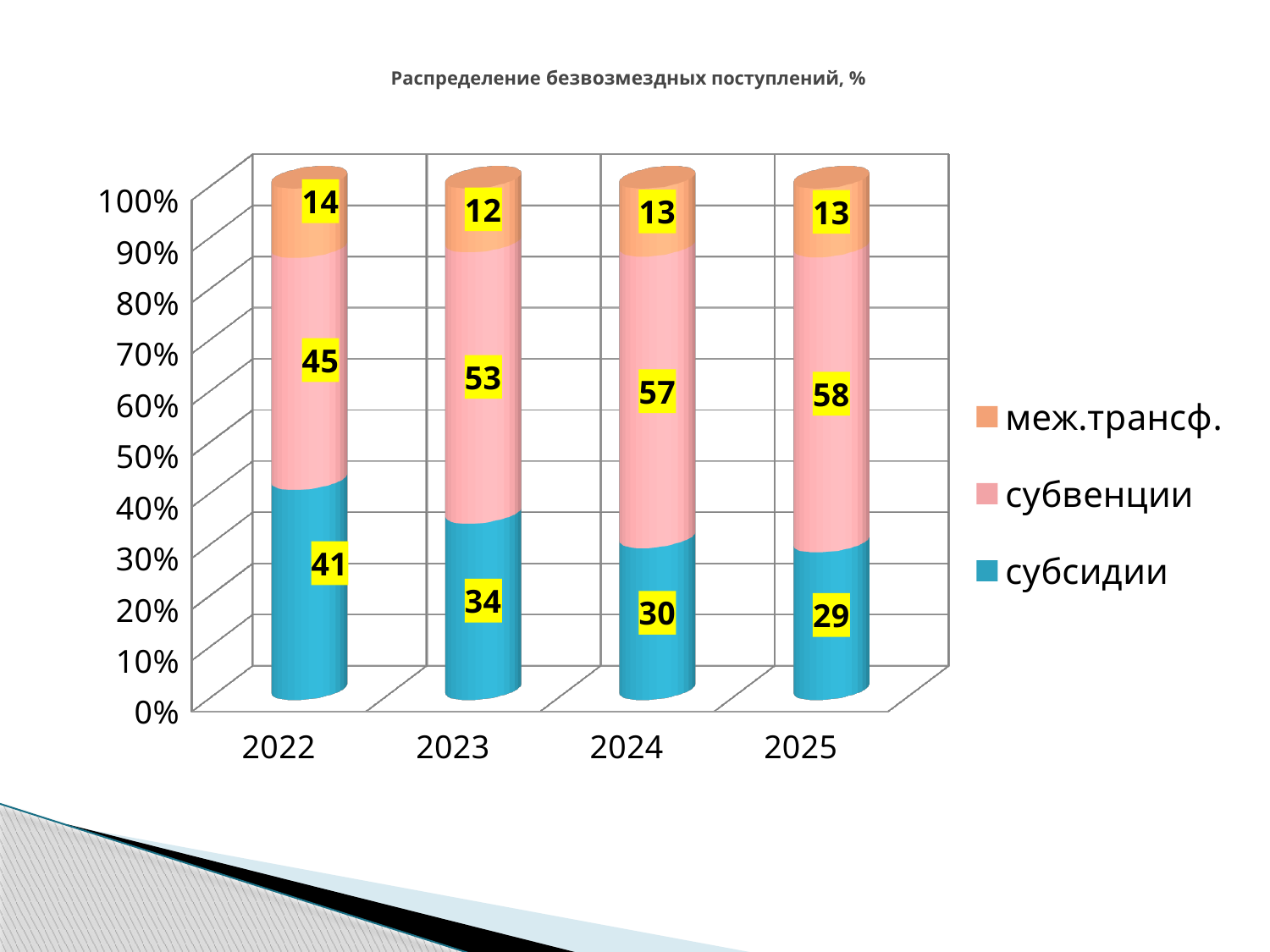
Do the values for субсидии rise or fall from 2022 to 2025? fall What is the value for меж.трансф. in 2023? 12 In which year is the value for субсидии the lowest? 2025 How many years are shown on the x axis? 4 What is the title of the chart? Распределение безвозмездных поступлений, % Which is larger in 2023: субсидии or субвенции? субвенции How many series does the legend list? 3 What is the value for субсидии in 2022? 41 What is the difference between the субвенции values for 2024 and 2022? 12 In which year is the value for субвенции the highest? 2025 What kind of chart is shown on the slide? stacked bar chart What is the value for субвенции in 2025? 58